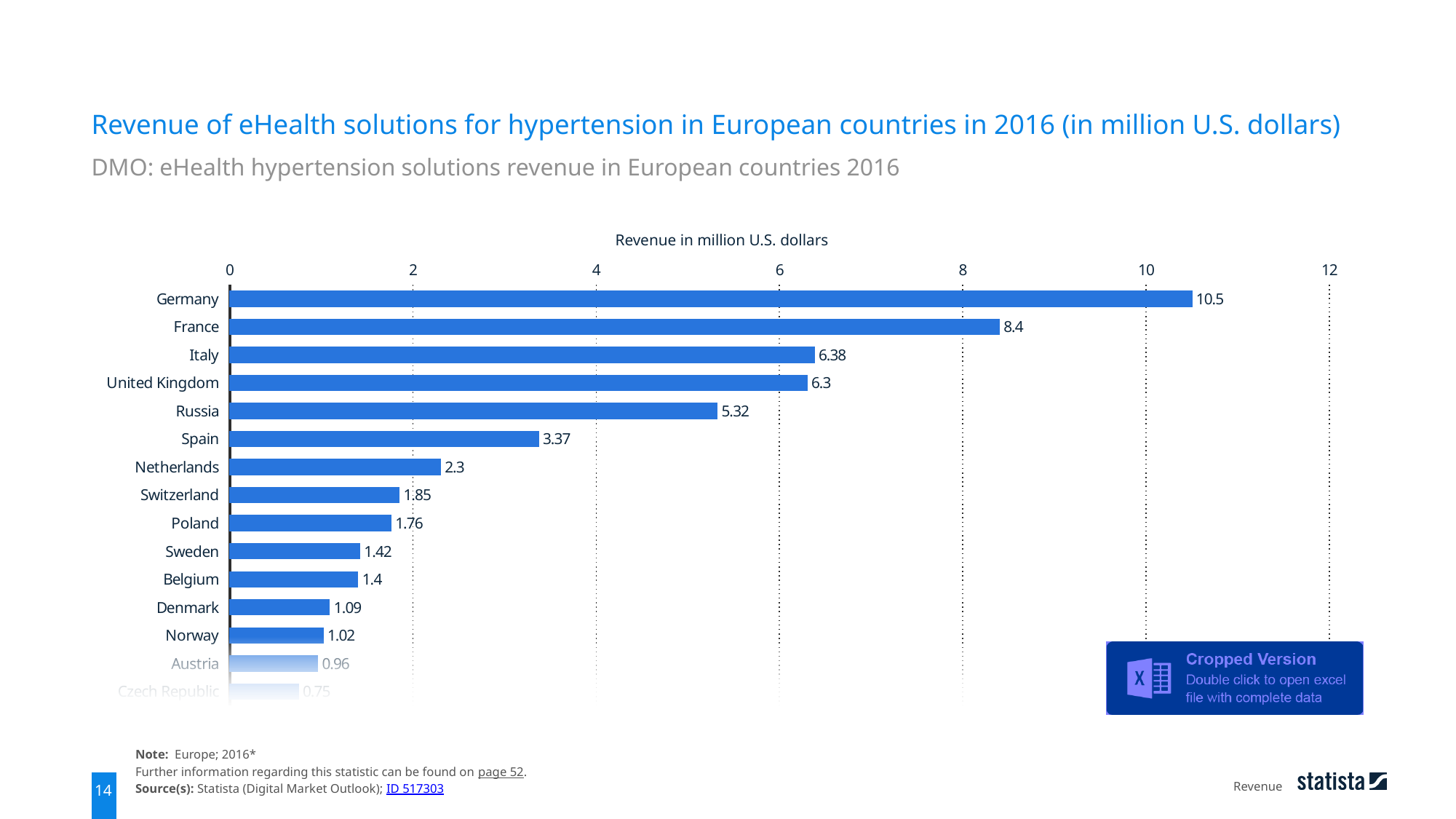
Which has a higher revenue, Spain or the Netherlands? Spain Which country has the highest revenue? Germany What kind of chart is shown on the slide? Bar chart Which country has the lowest revenue shown on the chart? Czech Republic What is the revenue for Russia? 5.32 Is the value for Russia greater or less than 4? greater How many countries are shown on the chart? 15 What is the revenue for Poland? 1.76 What is the revenue for Germany? 10.5 What is the label of the horizontal axis? Revenue in million U.S. dollars What is the difference in revenue between Russia and Spain? 1.95 What is the difference in revenue between Germany and France? 2.1